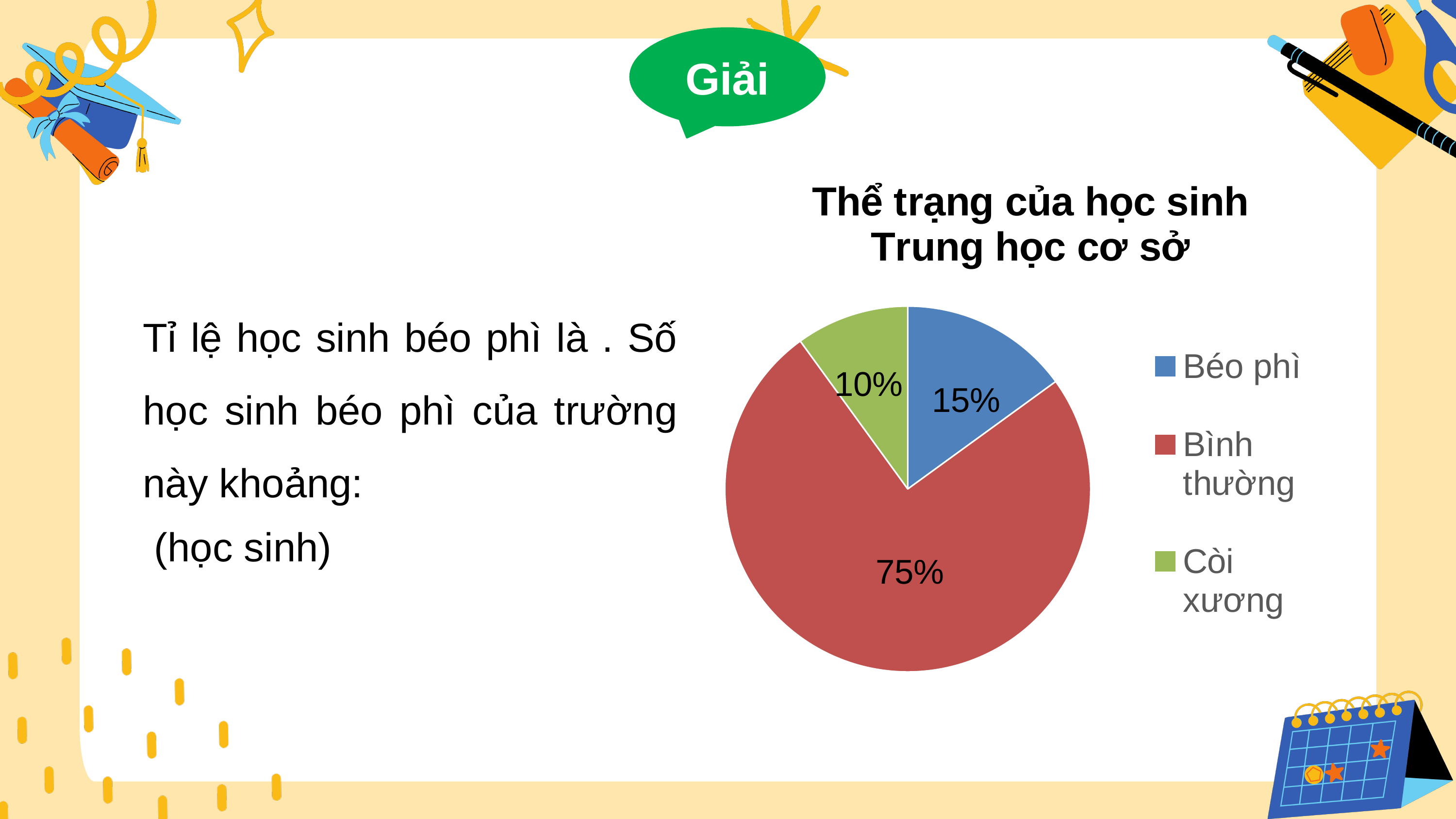
What is the combined share of Béo phì and Còi xương? 25% How many categories does the pie chart show? 3 Which category has the smallest share of the pie? Còi xương What kind of chart is shown on the slide? pie chart Which is larger, the share for Béo phì or the share for Còi xương? Béo phì What colour is the Bình thường slice? red What is the difference in percentage points between Bình thường and Béo phì? 60 What percentage of the pie is Bình thường? 75% What percentage of the pie is Béo phì? 15% Which category has the largest share of the pie? Bình thường What is the title of the chart? Thể trạng của học sinh Trung học cơ sở What percentage of the pie is Còi xương? 10%